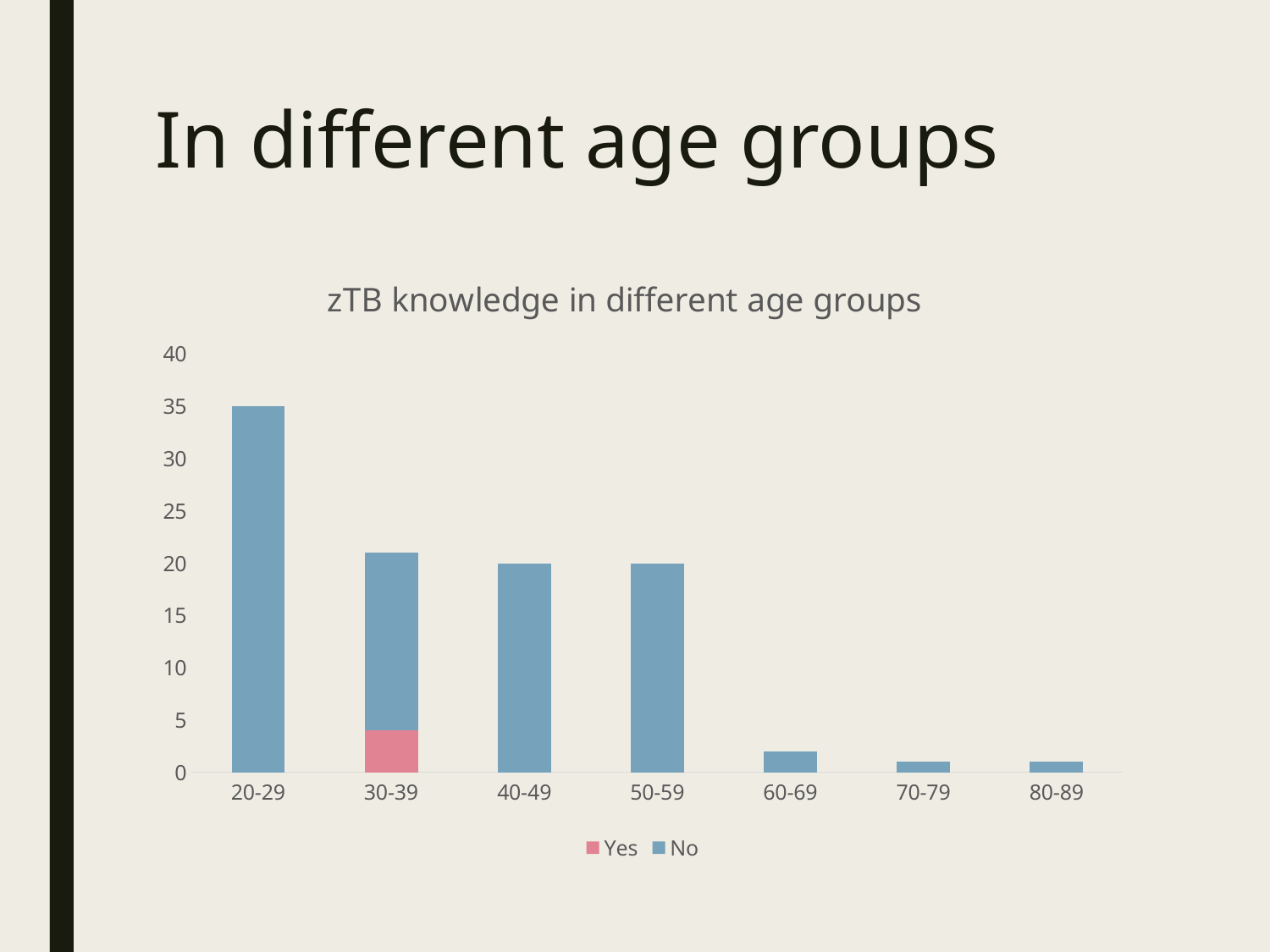
What is the title of the chart? zTB knowledge in different age groups Is the value for the 20-29 age group greater or less than 30? greater Which age group is the only one with a 'Yes' segment? 30-39 How many age groups are shown on the x axis? 7 Which age group has the tallest bar? 20-29 Which bar is taller, 20-29 or 30-39? 20-29 What type of chart is shown on the slide? Stacked bar chart Which bar is taller, 50-59 or 60-69? 50-59 Is the total value for the 30-39 age group greater or less than 20? greater How many series does the legend list? 2 Do the bar heights generally rise or fall from the 20-29 group to the 80-89 group? fall Is the value for the 60-69 age group greater or less than 5? less